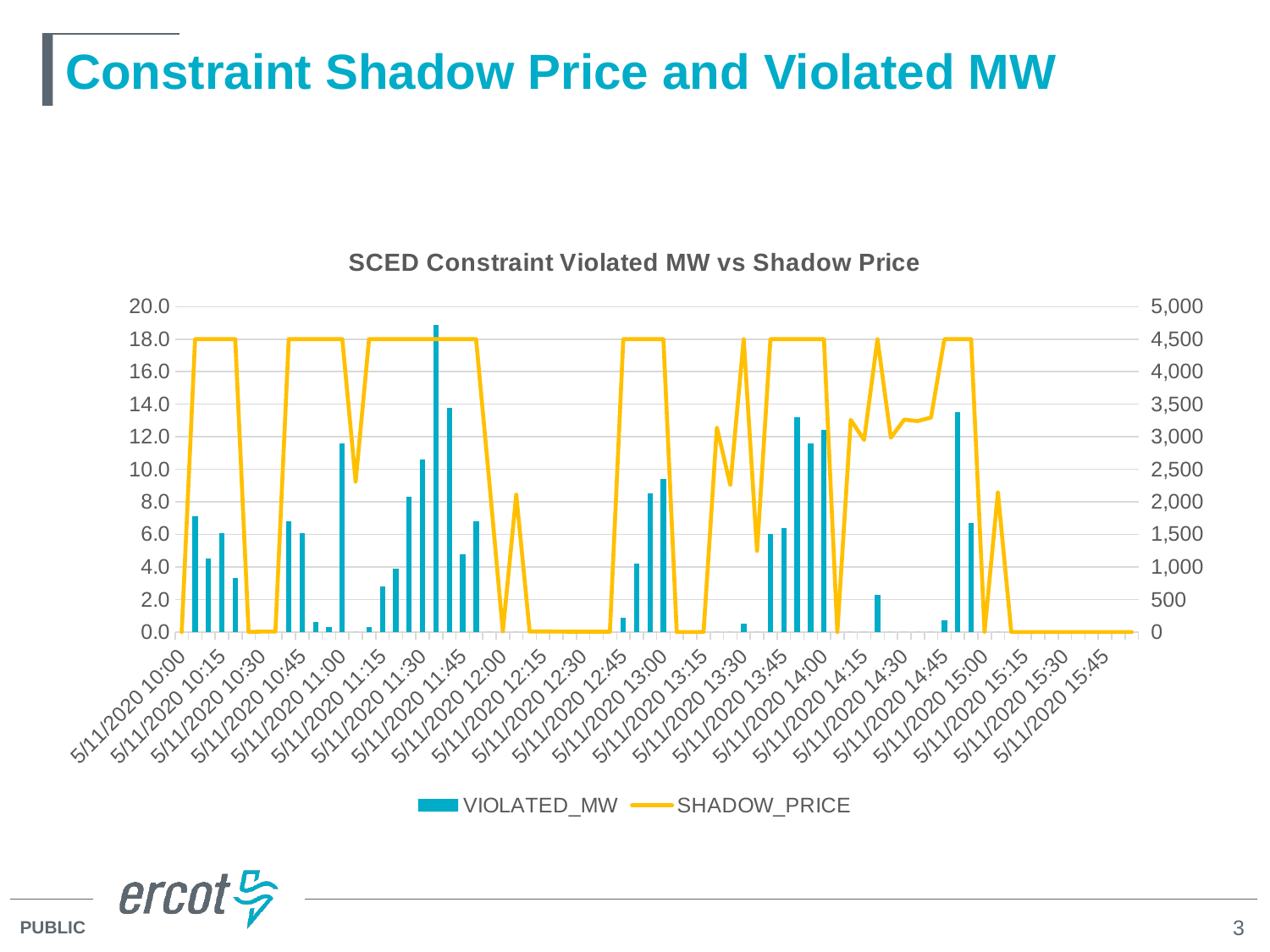
Is the highest VIOLATED_MW bar greater or less than 18.0? greater What kind of chart is shown on the slide? A combined bar and line chart What is the title of the chart? SCED Constraint Violated MW vs Shadow Price What is the maximum value shown on the left-hand (violated MW) axis? 20.0 What are the two series named in the legend? VIOLATED_MW and SHADOW_PRICE Is the SHADOW_PRICE value at 5/11/2020 12:15 greater or less than 500? less How many series does the legend list? 2 At what level does the SHADOW_PRICE line plateau when it is at its highest? 4,500 What is the maximum value shown on the right-hand (shadow price) axis? 5,000 Is the SHADOW_PRICE value at 5/11/2020 14:30 greater or less than 2,500? greater How many time labels are shown on the x axis? 24